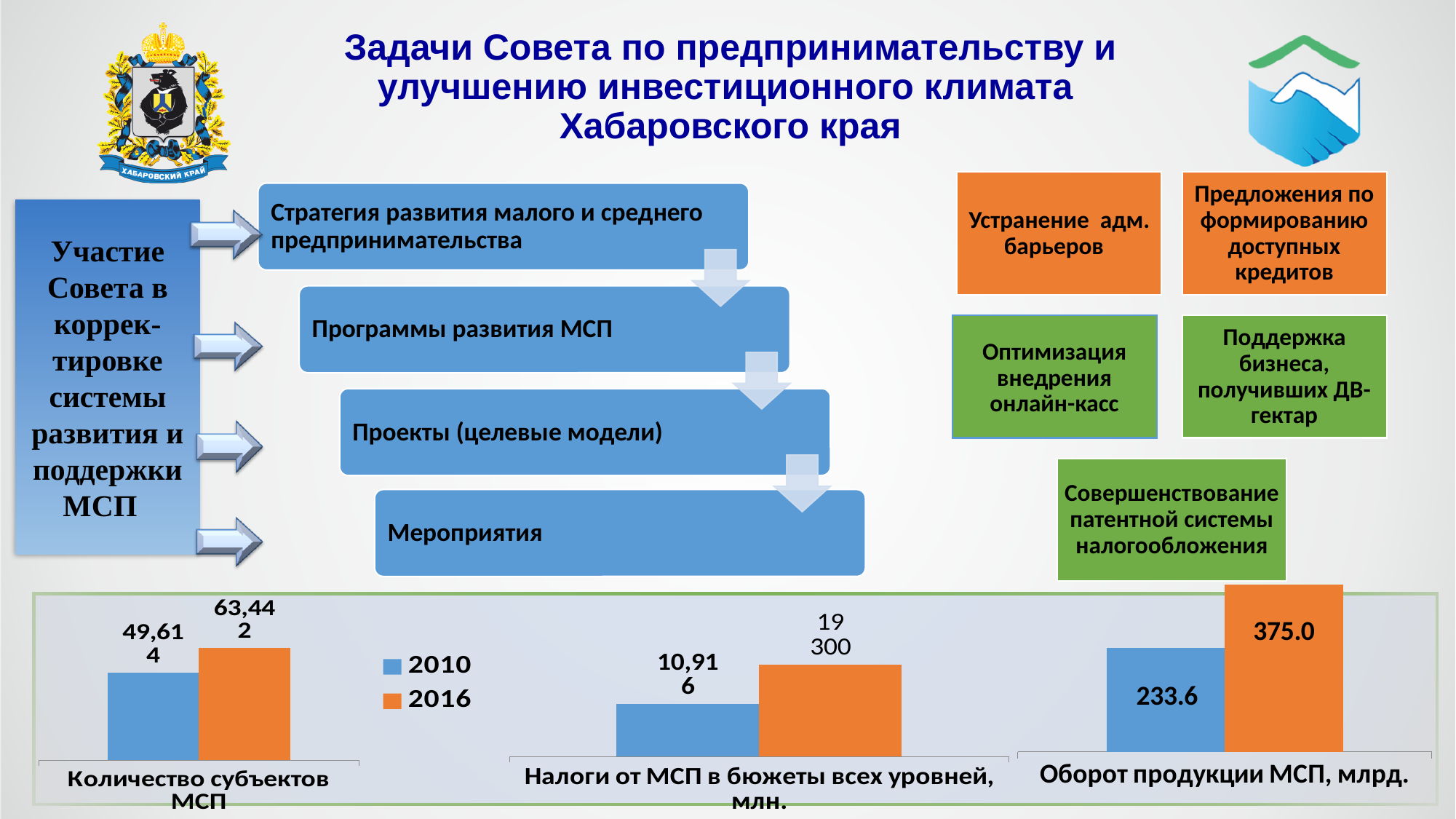
In the legend at the bottom of the slide, which colour represents 2016? orange On the 'Количество субъектов МСП' chart, what is the value for 2010? 49,614 On the 'Оборот продукции МСП, млрд.' chart, what is the value for 2016? 375.0 On the 'Количество субъектов МСП' chart, what is the value for 2016? 63,442 On the 'Количество субъектов МСП' chart, what is the difference between the 2016 and 2010 values? 13,828 What type of chart is used for 'Оборот продукции МСП, млрд.'? bar chart On the 'Налоги от МСП в бюджеты всех уровней, млн.' chart, what is the value for 2010? 10,916 On the 'Оборот продукции МСП, млрд.' chart, what is the value for 2010? 233.6 On the 'Налоги от МСП в бюджеты всех уровней, млн.' chart, what is the value for 2016? 19 300 On the 'Оборот продукции МСП, млрд.' chart, by how much does the 2016 value exceed the 2010 value? 141.4 On the 'Налоги от МСП в бюджеты всех уровней, млн.' chart, which year has the larger value, 2010 or 2016? 2016 How many series does the legend at the bottom of the slide list? 2